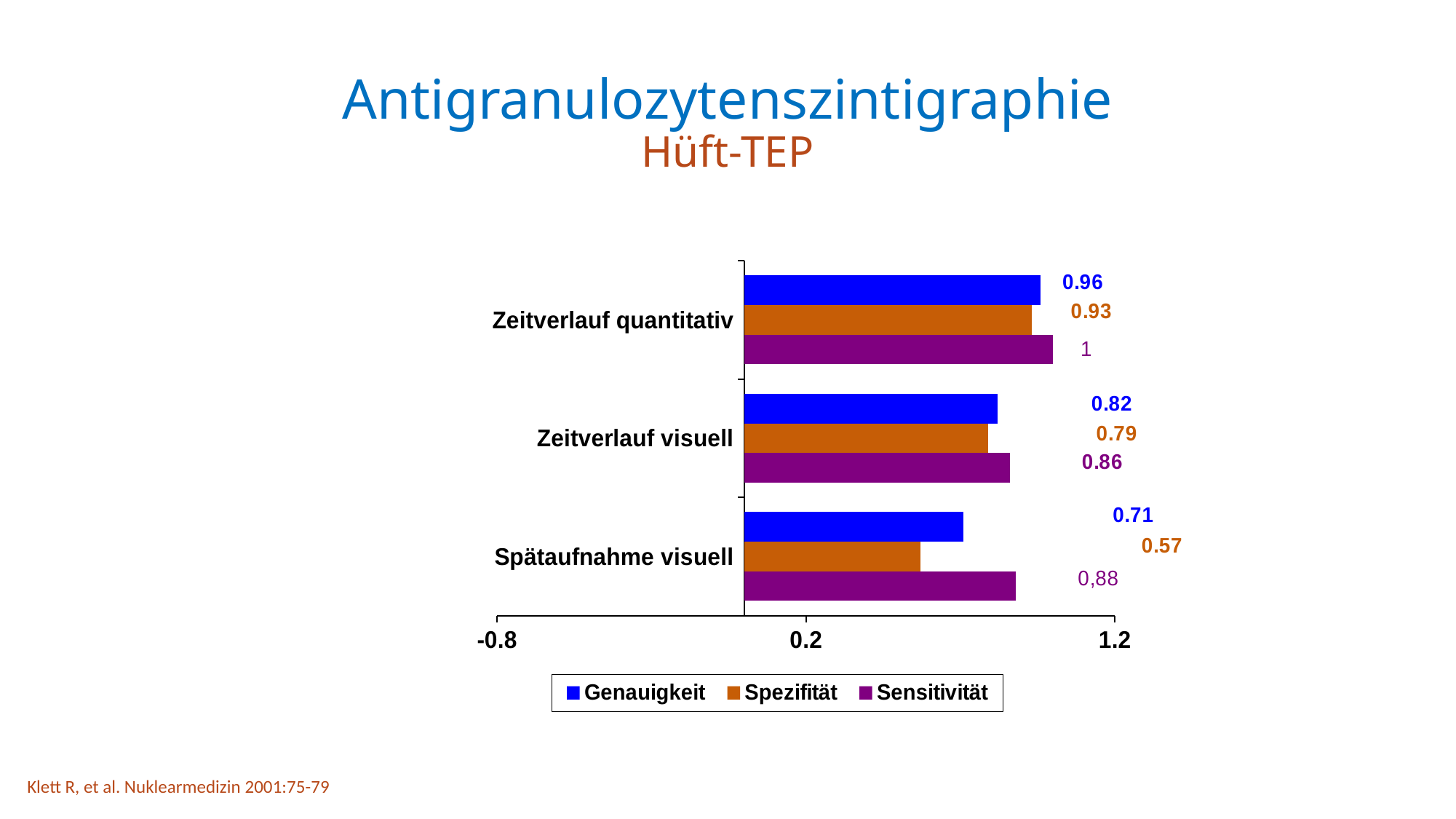
What is the Spezifität value for Spätaufnahme visuell? 0.57 Which category has the lowest Spezifität value? Spätaufnahme visuell What is the difference between the Genauigkeit values for Zeitverlauf quantitativ and Zeitverlauf visuell? 0.14 Which is larger for Spätaufnahme visuell: Genauigkeit or Spezifität? Genauigkeit What kind of chart is shown on the slide? Bar chart How many categories are shown on the y axis? 3 What is the Sensitivität value for Spätaufnahme visuell? 0,88 Which series is shown in purple in the legend? Sensitivität What is the Sensitivität value for Zeitverlauf visuell? 0.86 Which category has the highest Genauigkeit value? Zeitverlauf quantitativ How many series does the legend list? 3 What is the Genauigkeit value for Zeitverlauf quantitativ? 0.96